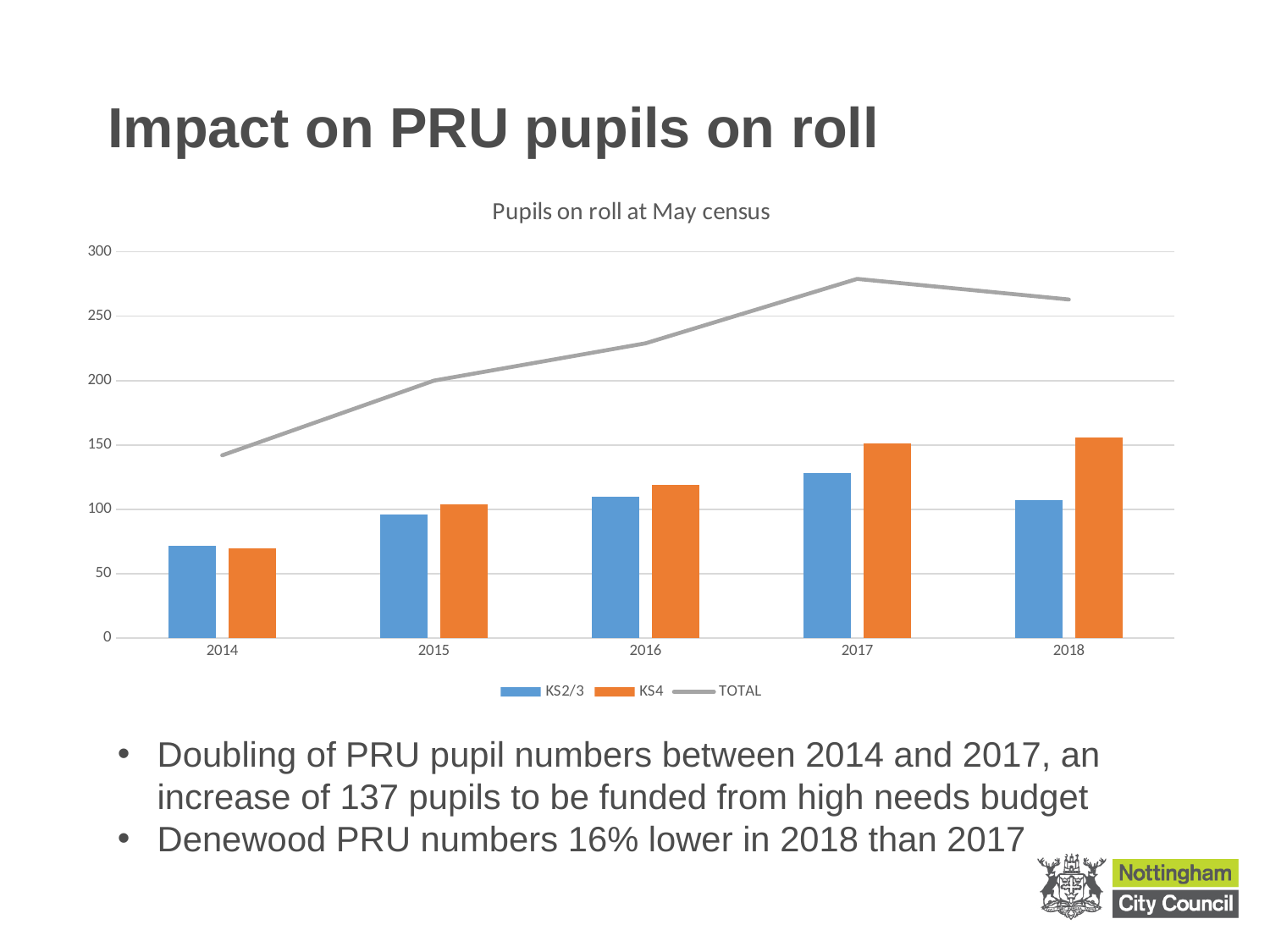
Is the TOTAL value for 2017 greater or less than 250? greater In which year is the TOTAL line at its lowest? 2014 How many series does the chart legend list? 3 How many years are shown on the x axis of the chart? 5 In which year is the KS4 bar the shortest? 2014 In 2017, which is larger, the KS2/3 bar or the KS4 bar? KS4 Does the TOTAL line rise or fall between 2014 and 2017? rise What is the title of the chart? Pupils on roll at May census Is the KS4 value for 2014 greater or less than 100? less In which year is the TOTAL line at its highest? 2017 Which series is plotted as a line rather than bars? TOTAL In which year is the KS2/3 bar the tallest? 2017